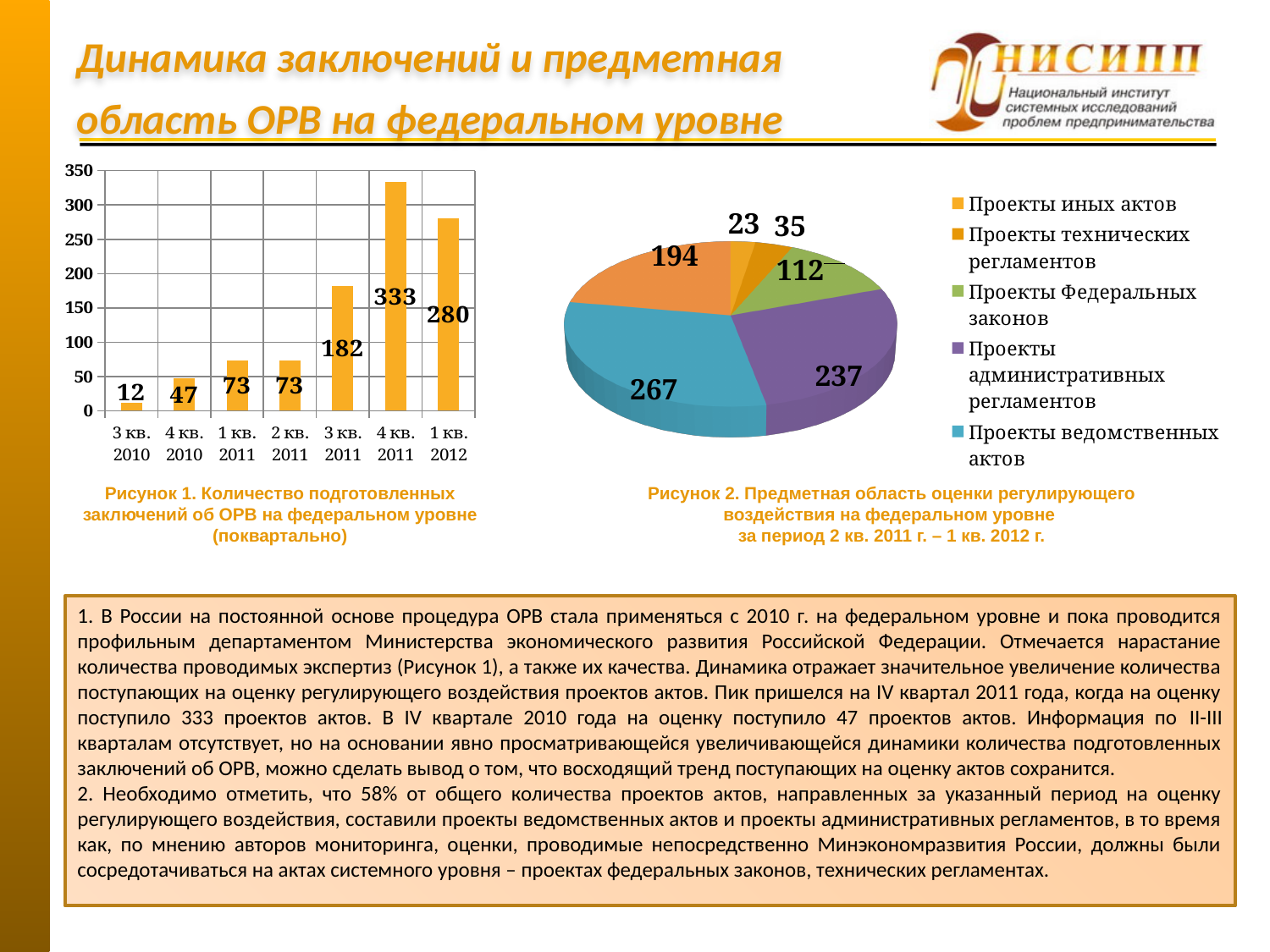
What kind of chart is Рисунок 1? bar chart In the bar chart (Рисунок 1), which quarter has the lowest value? 3 кв. 2010 How many quarters are shown in the bar chart (Рисунок 1)? 7 In the bar chart (Рисунок 1), what is the difference between the values for 4 кв. 2011 and 1 кв. 2012? 53 How many entries does the legend of the pie chart (Рисунок 2) list? 5 In the pie chart (Рисунок 2), what is the difference between the slice for Проекты ведомственных актов and the slice for Проекты административных регламентов? 30 In the pie chart (Рисунок 2), what is the value of the slice for Проекты Федеральных законов (green)? 112 In the bar chart (Рисунок 1), what is the value for 3 кв. 2010? 12 In the bar chart (Рисунок 1), do the values generally rise or fall from 3 кв. 2010 to 4 кв. 2011? rise In the bar chart (Рисунок 1), which quarter has the highest value? 4 кв. 2011 In the bar chart (Рисунок 1), what is the value for 4 кв. 2011? 333 In the bar chart (Рисунок 1), which is larger: the value for 3 кв. 2011 or the value for 1 кв. 2012? 1 кв. 2012